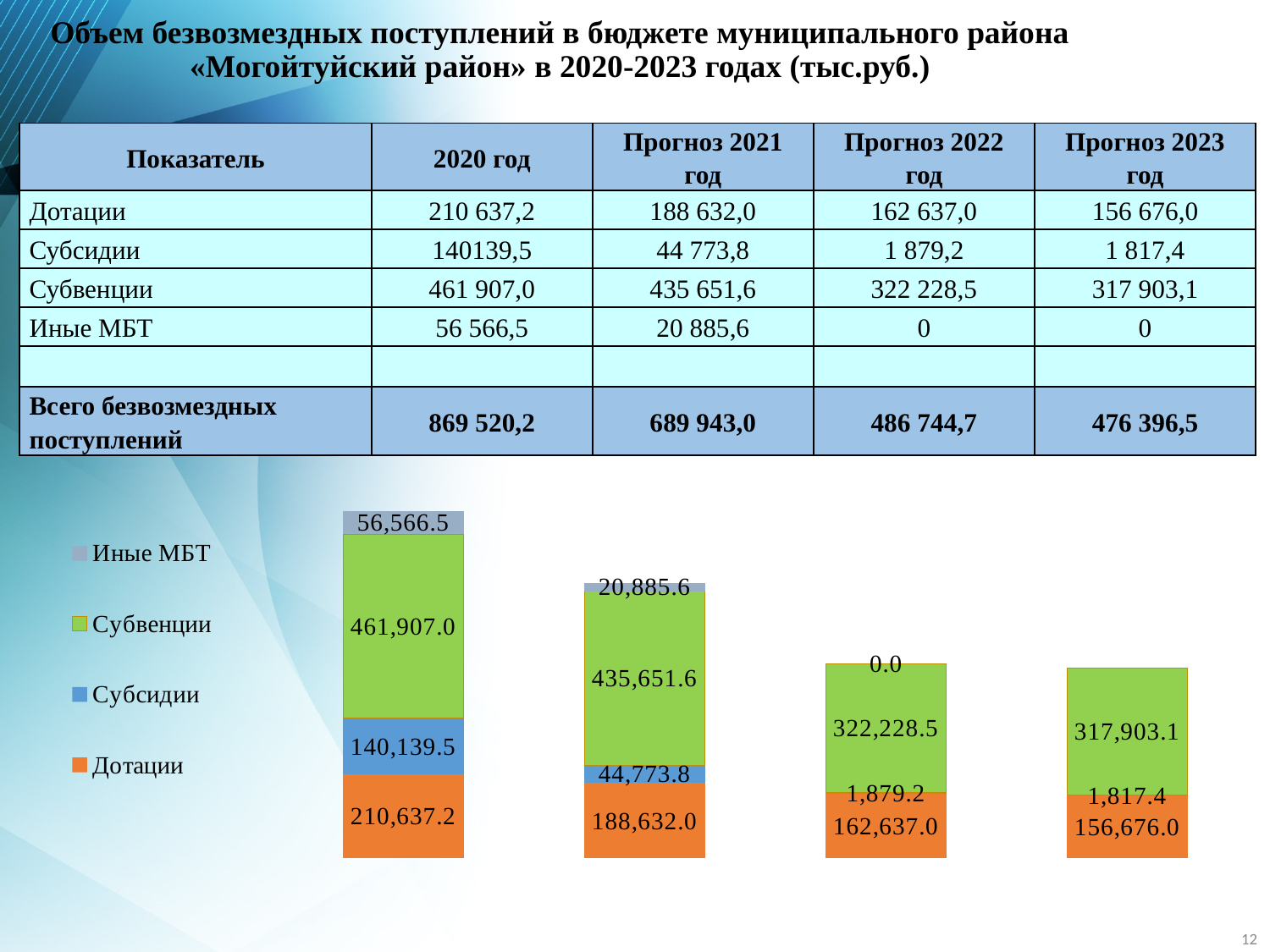
In the chart, what is the difference between the Субвенции values of the leftmost bar and the second bar from the left? 26,255.4 In the chart, what is the value of the Субсидии segment in the second bar from the left? 44,773.8 In the chart, what is the value of the Иные МБТ segment in the third bar from the left? 0.0 How many series does the chart legend list? 4 In the chart, what is the total of the third bar from the left? 486,744.7 How many stacked bars are plotted in the chart? 4 In the chart, what is the value of the Дотации segment in the rightmost bar? 156,676.0 In the chart, what is the value of the Субвенции segment in the leftmost bar? 461,907.0 In the chart, which is larger: the Субсидии segment of the leftmost bar or the Субсидии segment of the second bar from the left? the leftmost bar Which bar in the chart has the largest Субвенции segment? the leftmost bar What type of chart is shown on the slide? stacked bar chart Which bar in the chart has the smallest Дотации segment? the rightmost bar